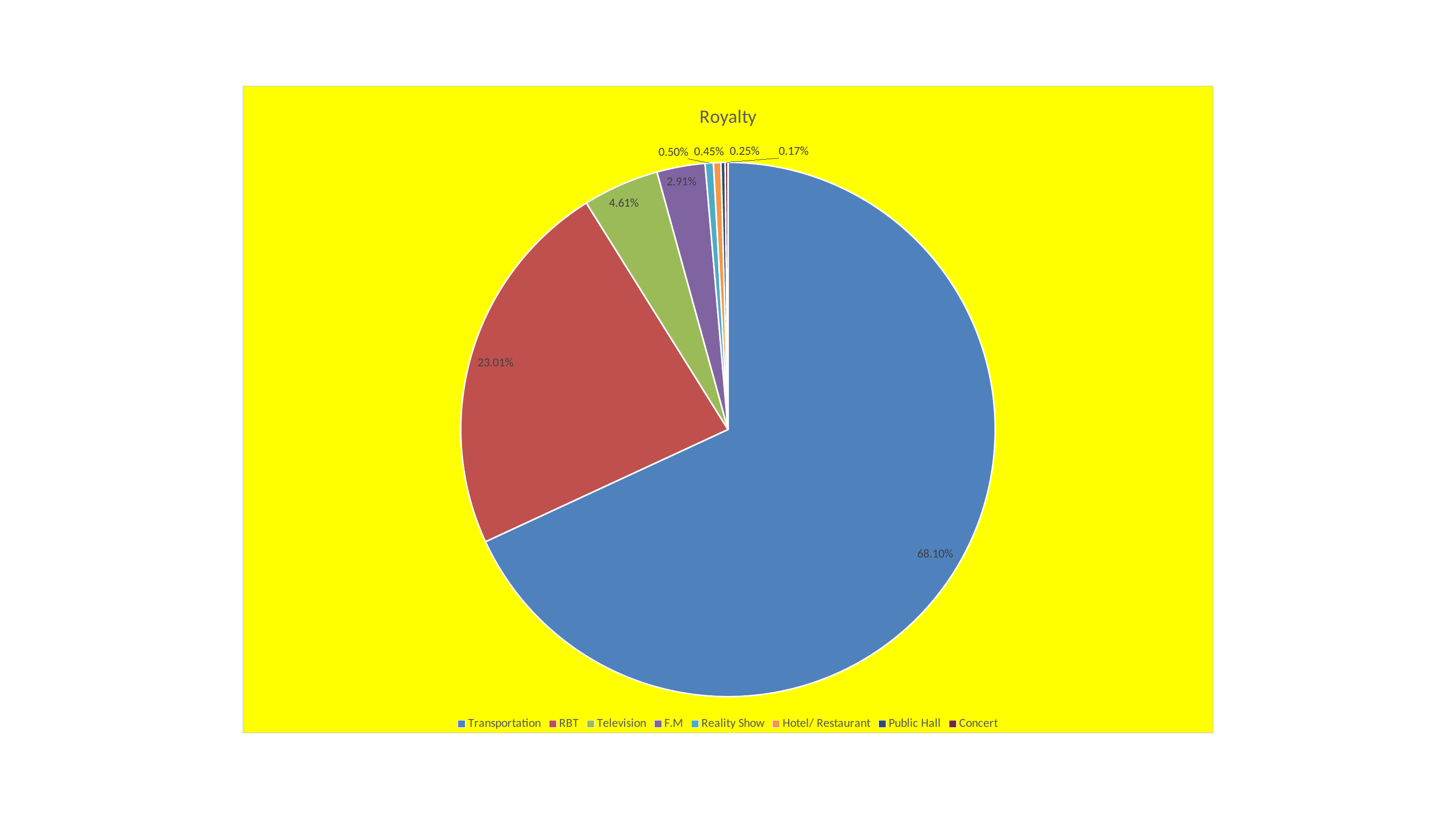
What is the value shown for Television? 4.61% What is the value shown for Public Hall? 0.25% What kind of chart is shown on the slide? pie chart What is the value shown for F.M? 2.91% Which category has the smallest slice of the pie? Concert How many categories does the legend list? 8 What is the value shown for RBT? 23.01% Which category has the largest slice of the pie? Transportation Which is larger, the Television slice or the F.M slice? Television What is the title of the chart? Royalty What is the difference between the Transportation and RBT shares? 45.09% What share of the pie does Transportation account for? 68.10%